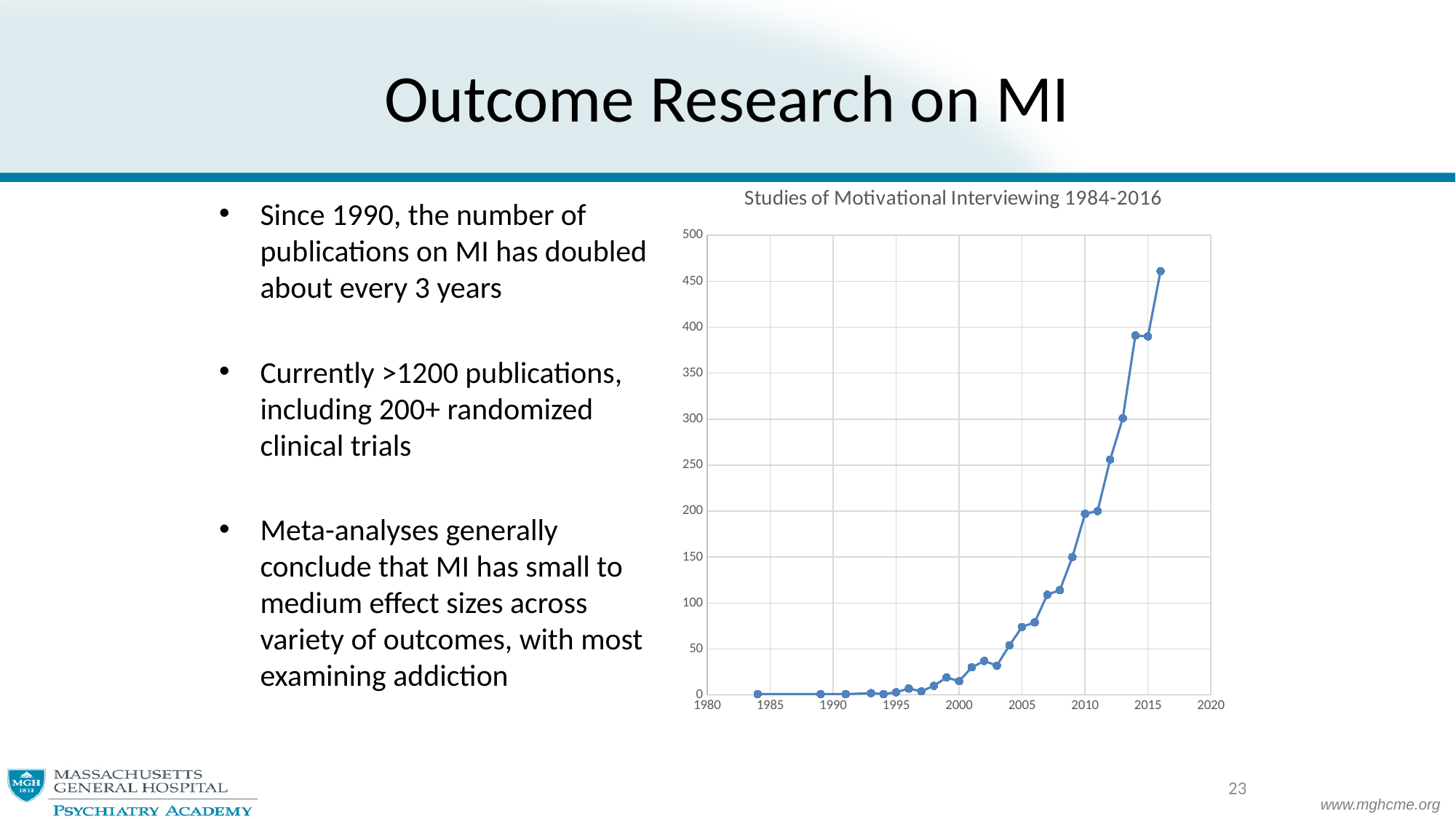
Is the value for 2000 greater or less than 50? less What kind of chart is shown on the slide? line chart What is the highest value shown on the y axis? 500 Is the value for 2010 greater or less than 150? greater Is the value for 2013 greater or less than 250? greater Which year has the highest value on the chart? 2016 Do the values generally rise or fall as the years increase along the x axis? rise What is the title of the chart? Studies of Motivational Interviewing 1984-2016 Which is larger, the value for 2016 or the value for 2010? 2016